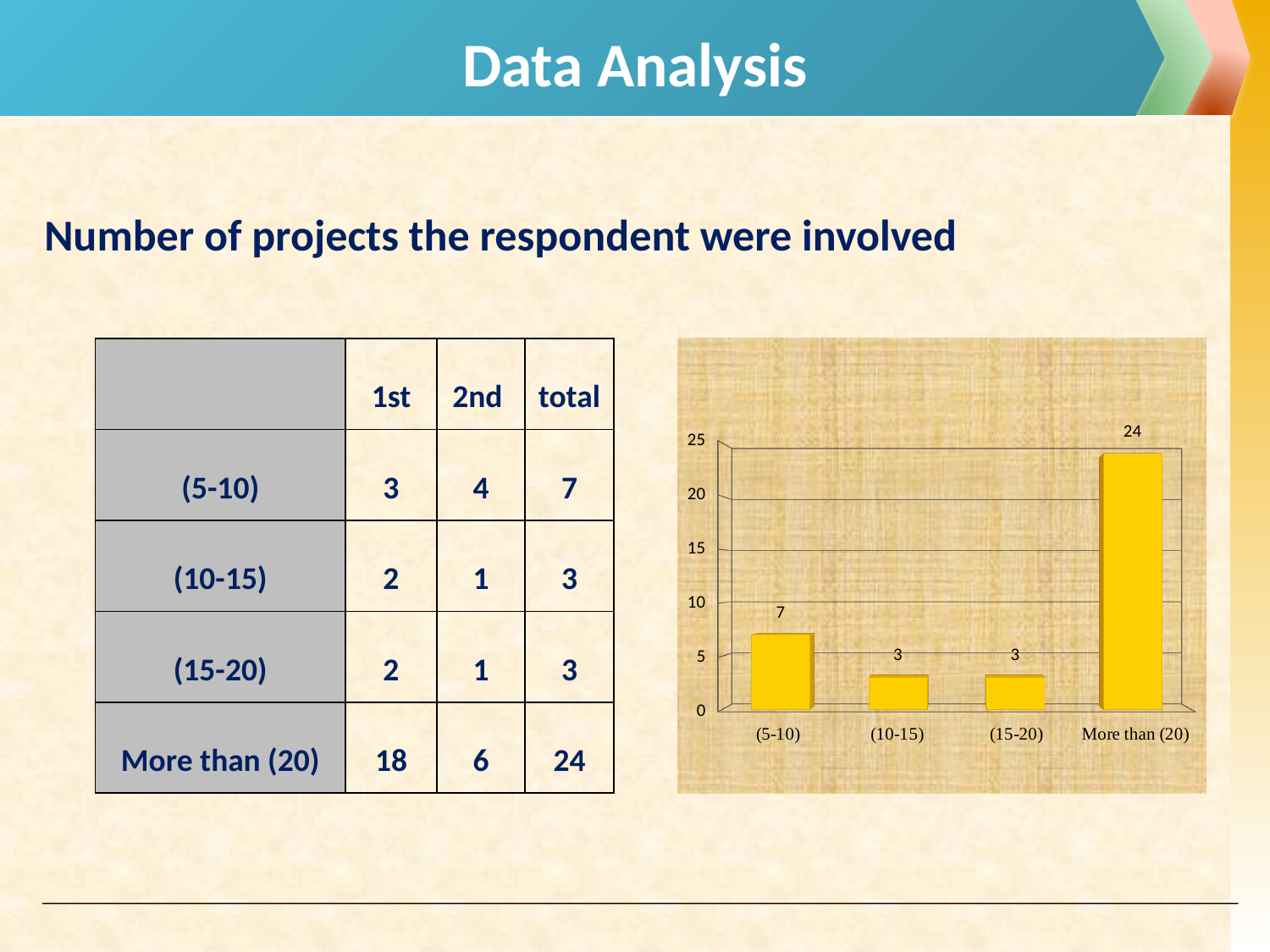
How many categories are shown on the x axis of the chart? 4 What is the highest value shown on the chart's vertical axis? 25 What is the difference between the values for More than (20) and (5-10)? 17 Is the value for More than (20) greater or less than 20? greater What is the value for the (10-15) category in the chart? 3 Which is larger, the value for (5-10) or the value for (10-15)? (5-10) Which category has the highest value in the chart? More than (20) Is the value for (15-20) greater or less than 5? less What is the difference between the values for (5-10) and (15-20)? 4 What is the value for the More than (20) category in the chart? 24 What is the value for the (5-10) category in the chart? 7 What kind of chart is shown on the slide? bar chart